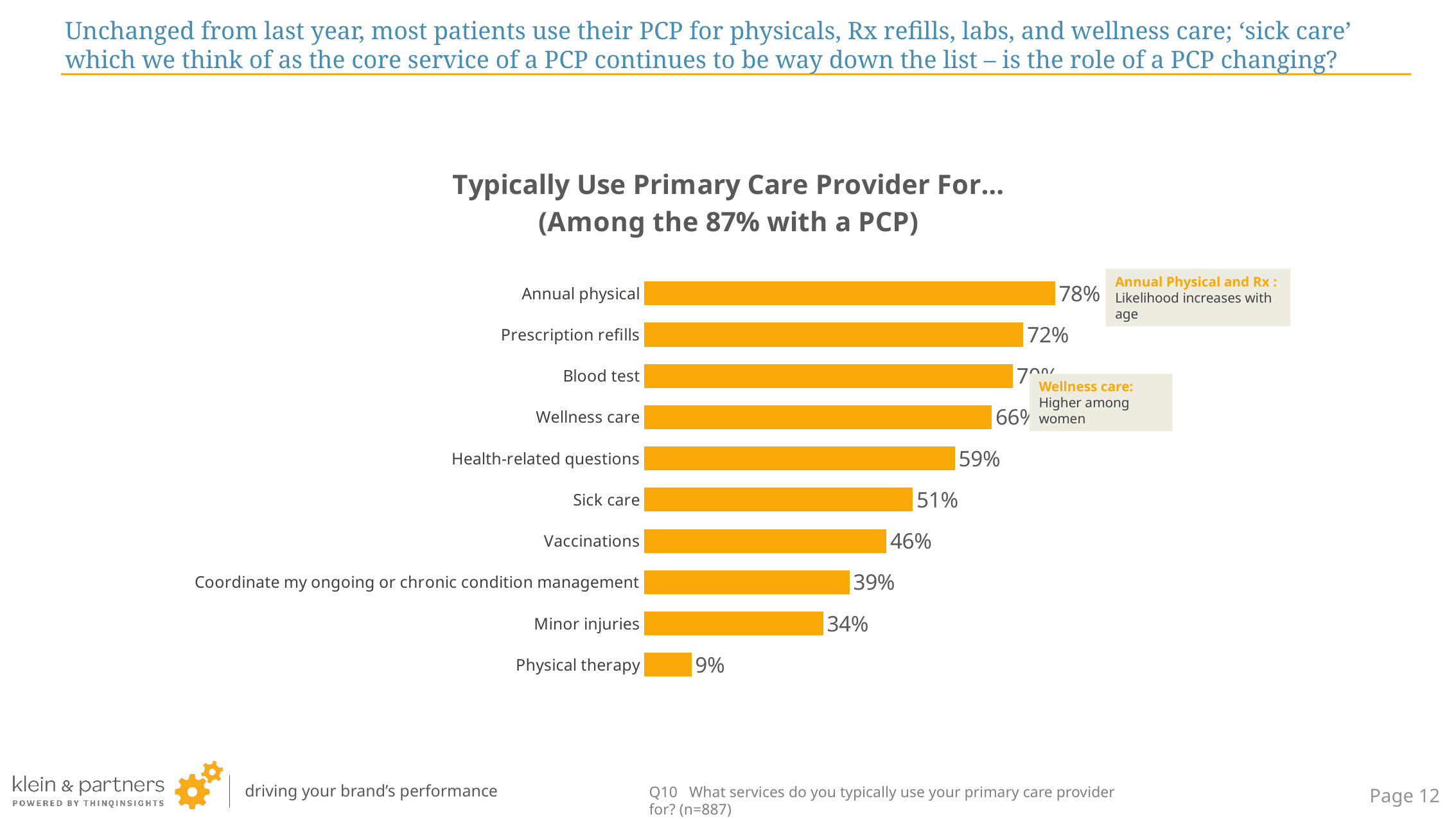
What is the value for Prescription refills? 72% What is the title of the chart? Typically Use Primary Care Provider For… (Among the 87% with a PCP) What is the value for Sick care? 51% What percentage of patients typically use their PCP for an annual physical? 78% How many categories are shown in the chart? 10 Which category has the highest value? Annual physical What is the value for Physical therapy? 9% What kind of chart is shown on the slide? Bar chart Which category has the lowest value? Physical therapy Which is larger, the value for Vaccinations or the value for Minor injuries? Vaccinations What is the value for Coordinate my ongoing or chronic condition management? 39% What is the difference between the values for Annual physical and Sick care? 27%